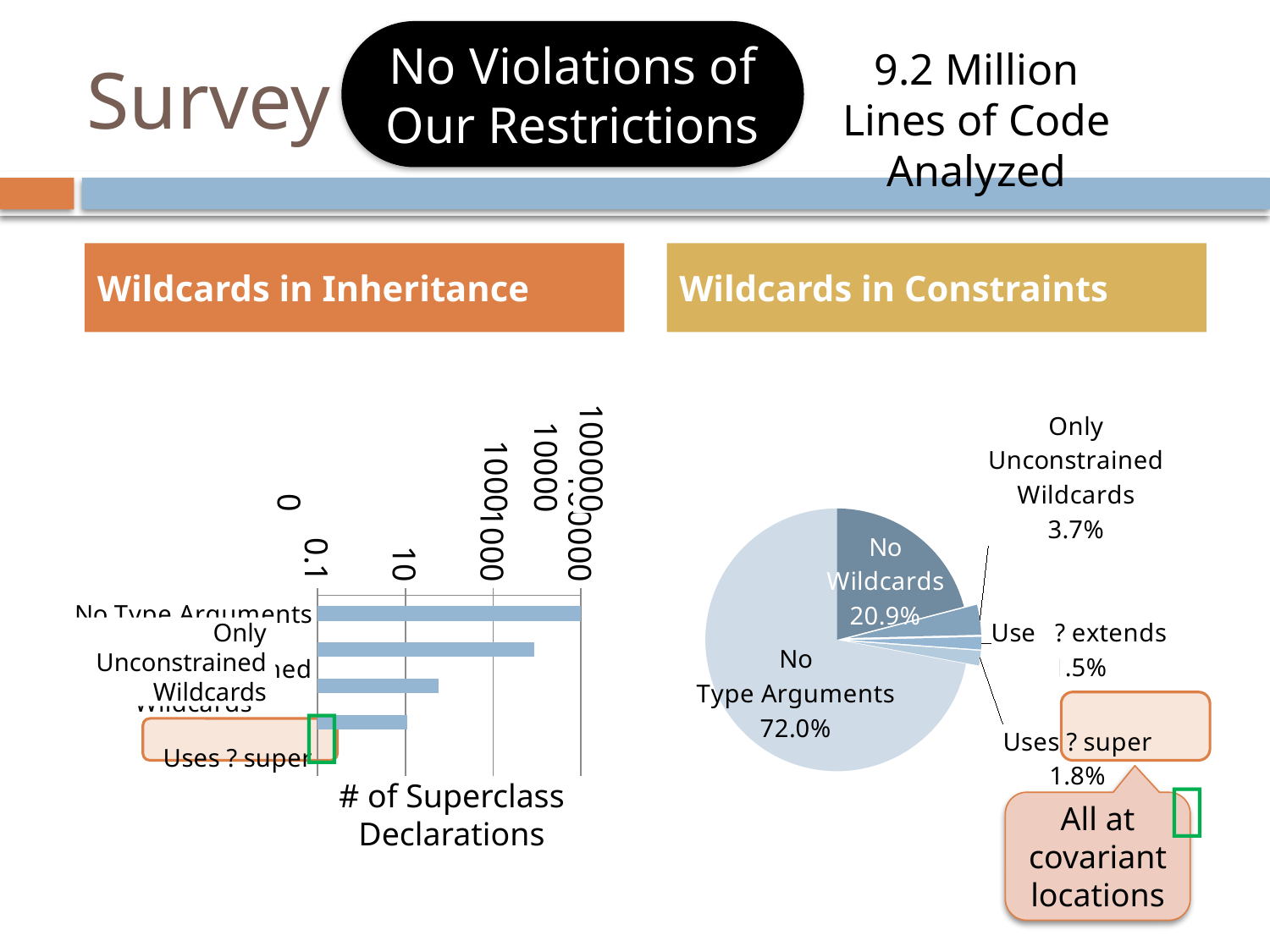
In the Wildcards in Inheritance bar chart, how many bars are plotted? 4 What kind of chart is the Wildcards in Constraints chart? Pie chart In the Wildcards in Constraints pie chart, what share is labelled for No Type Arguments? 72.0% In the Wildcards in Constraints pie chart, which slice is the largest? No Type Arguments In the Wildcards in Constraints pie chart, what share is labelled for Only Unconstrained Wildcards? 3.7% What is the axis title of the Wildcards in Inheritance bar chart? # of Superclass Declarations In the Wildcards in Constraints pie chart, what share is labelled for No Wildcards? 20.9% In the Wildcards in Constraints pie chart, which is larger: No Wildcards or Only Unconstrained Wildcards? No Wildcards In the Wildcards in Inheritance bar chart, which category has the longest bar? No Type Arguments In the Wildcards in Constraints pie chart, what share is labelled for Uses ? super? 1.8% What kind of chart is the Wildcards in Inheritance chart? Bar chart In the Wildcards in Constraints pie chart, how many percentage points larger is No Type Arguments than No Wildcards? 51.1